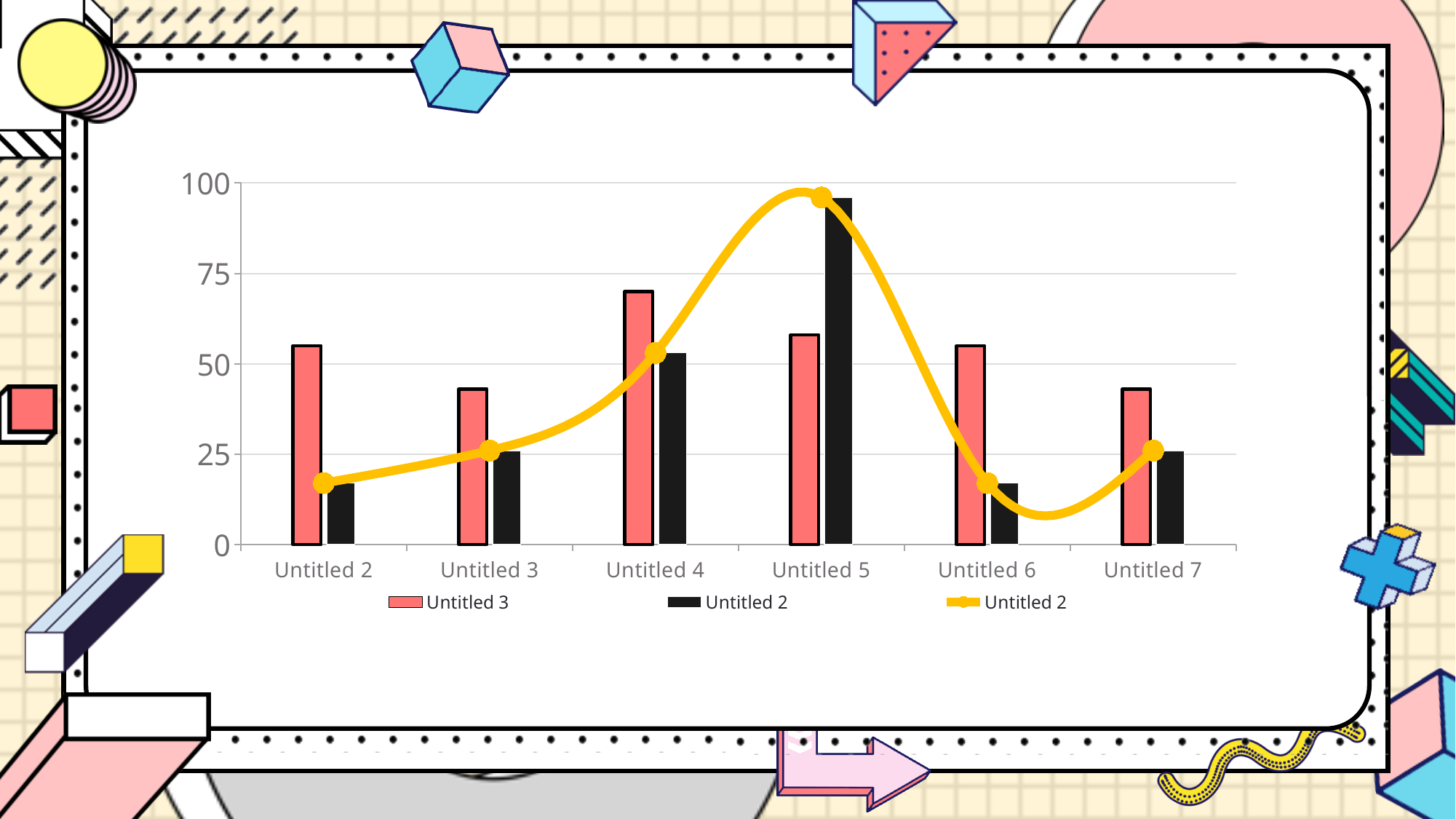
Is the black (Untitled 2) bar for Untitled 2 greater or less than 25? less How many series does the legend list? 3 Which category has the highest black (Untitled 2) bar? Untitled 5 Is the black (Untitled 2) bar for Untitled 5 greater or less than 75? greater Which category has the highest pink (Untitled 3) bar? Untitled 4 How many categories are shown on the x axis? 6 Is the pink (Untitled 3) bar for Untitled 4 greater or less than 50? greater What kind of chart is shown on the slide? A combined bar and line chart For Untitled 2, which is larger: the pink (Untitled 3) bar or the black (Untitled 2) bar? The pink (Untitled 3) bar For Untitled 5, which is larger: the pink (Untitled 3) bar or the black (Untitled 2) bar? The black (Untitled 2) bar What colour is the line series in the chart? Yellow